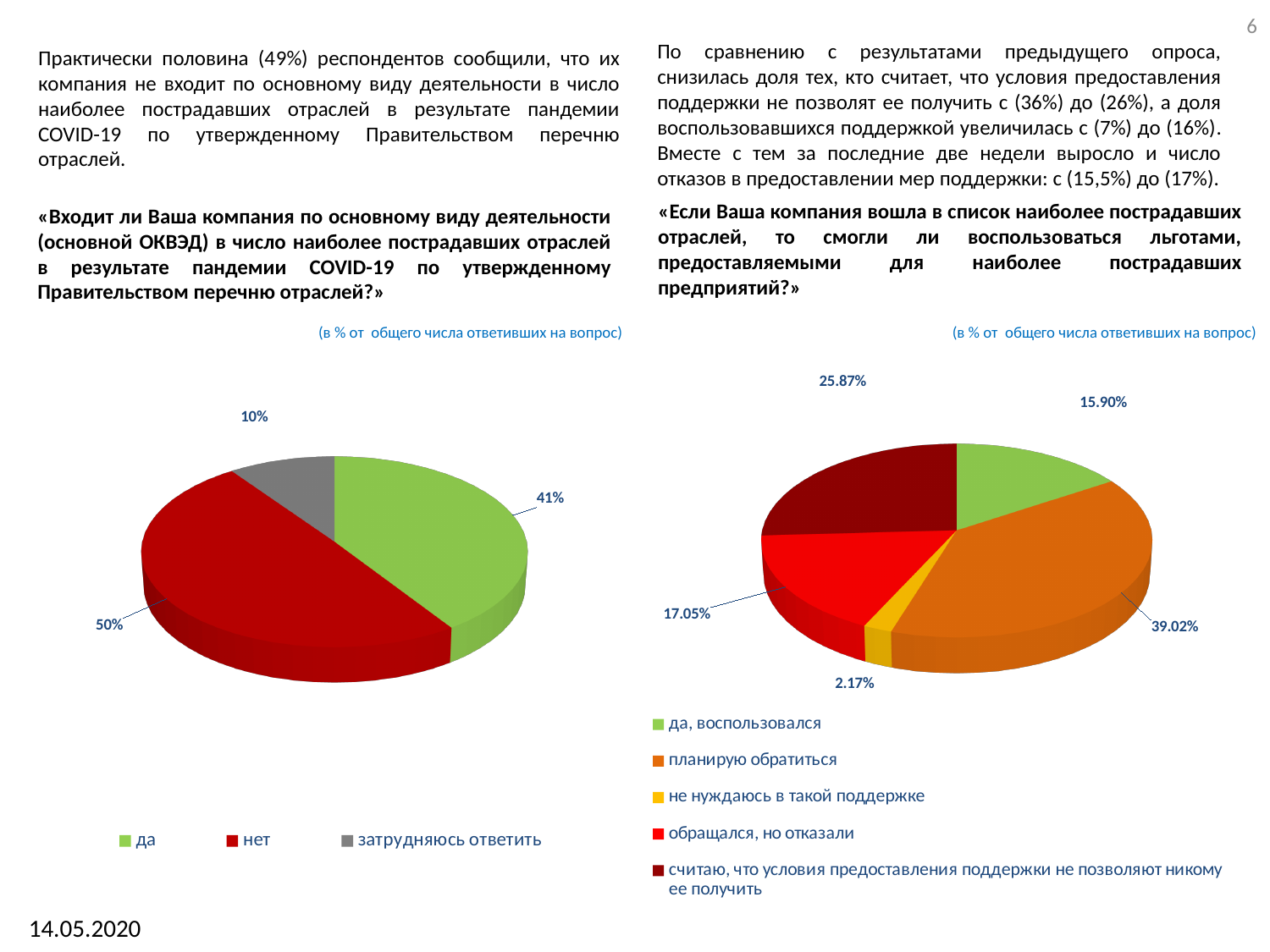
On the right pie chart, what share of respondents chose «обращался, но отказали»? 17.05% On the left pie chart, what is the difference in percentage points between «нет» and «да»? 9 What type of chart is shown on the left side of the slide? pie chart On the right pie chart, which answer has the largest share? планирую обратиться How many slices does the left pie chart have? 3 On the left pie chart, what share of respondents answered «да»? 41% How many entries does the legend of the right pie chart list? 5 On the left pie chart, which answer has the smallest share? затрудняюсь ответить On the right pie chart, which is larger: «да, воспользовался» or «обращался, но отказали»? обращался, но отказали On the left pie chart, what share of respondents answered «нет»? 50% On the right pie chart, what share of respondents chose «планирую обратиться»? 39.02% On the right pie chart, which answer has the smallest share? не нуждаюсь в такой поддержке